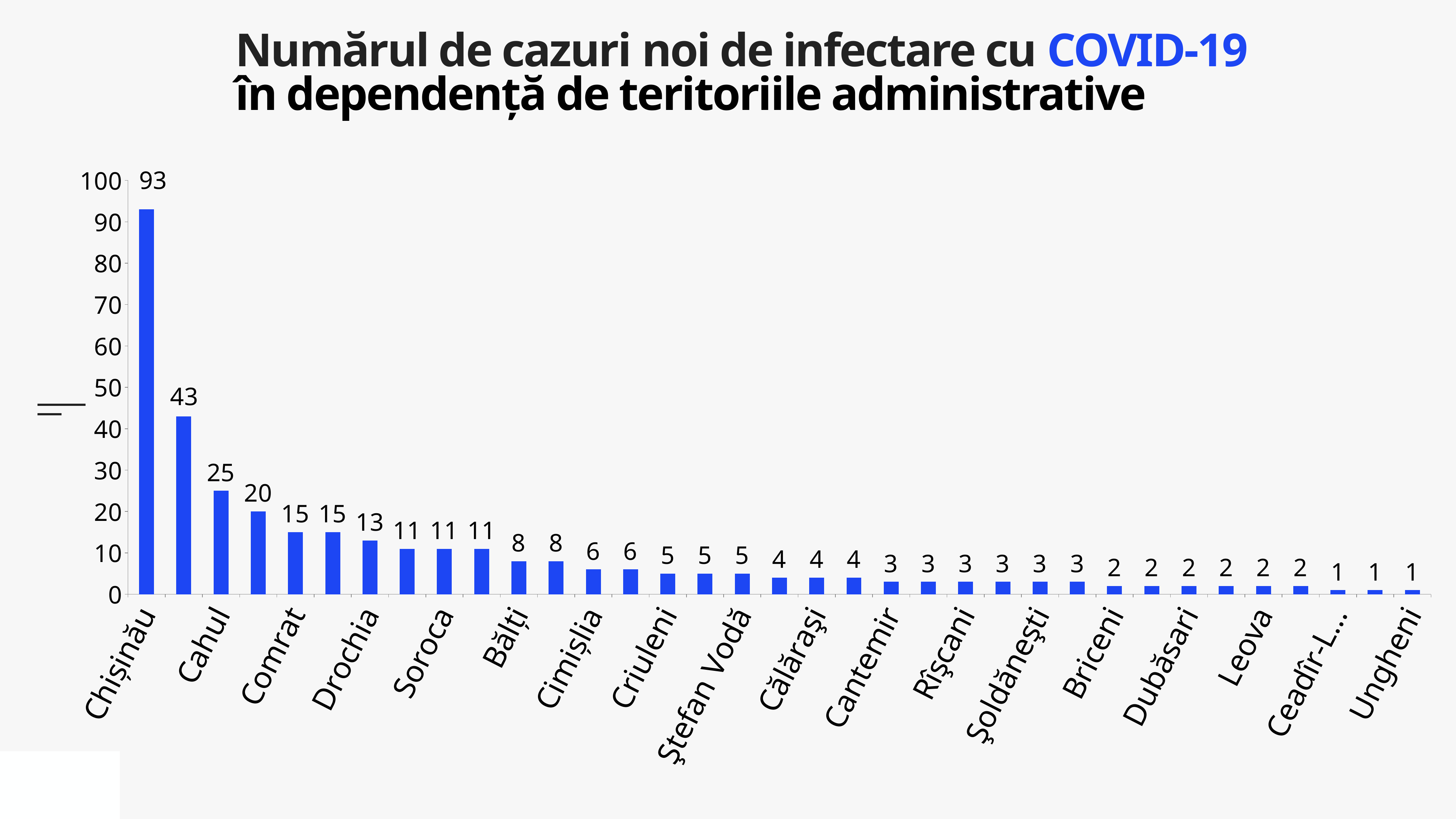
Which territory has the highest number of new cases? Chișinău Do the values rise or fall from left to right along the x axis? fall What kind of chart is shown on the slide? bar chart Which is larger, the value for Soroca or the value for Bălți? Soroca Is the value for Chișinău greater or less than 90? greater What is the value for Comrat? 15 What is the difference between the values for Chișinău and Comrat? 78 How many bars are plotted in the chart? 35 What is the value for Chișinău? 93 What is the value for Soroca? 11 What is the value for Bălți? 8 What is the value for Ungheni? 1